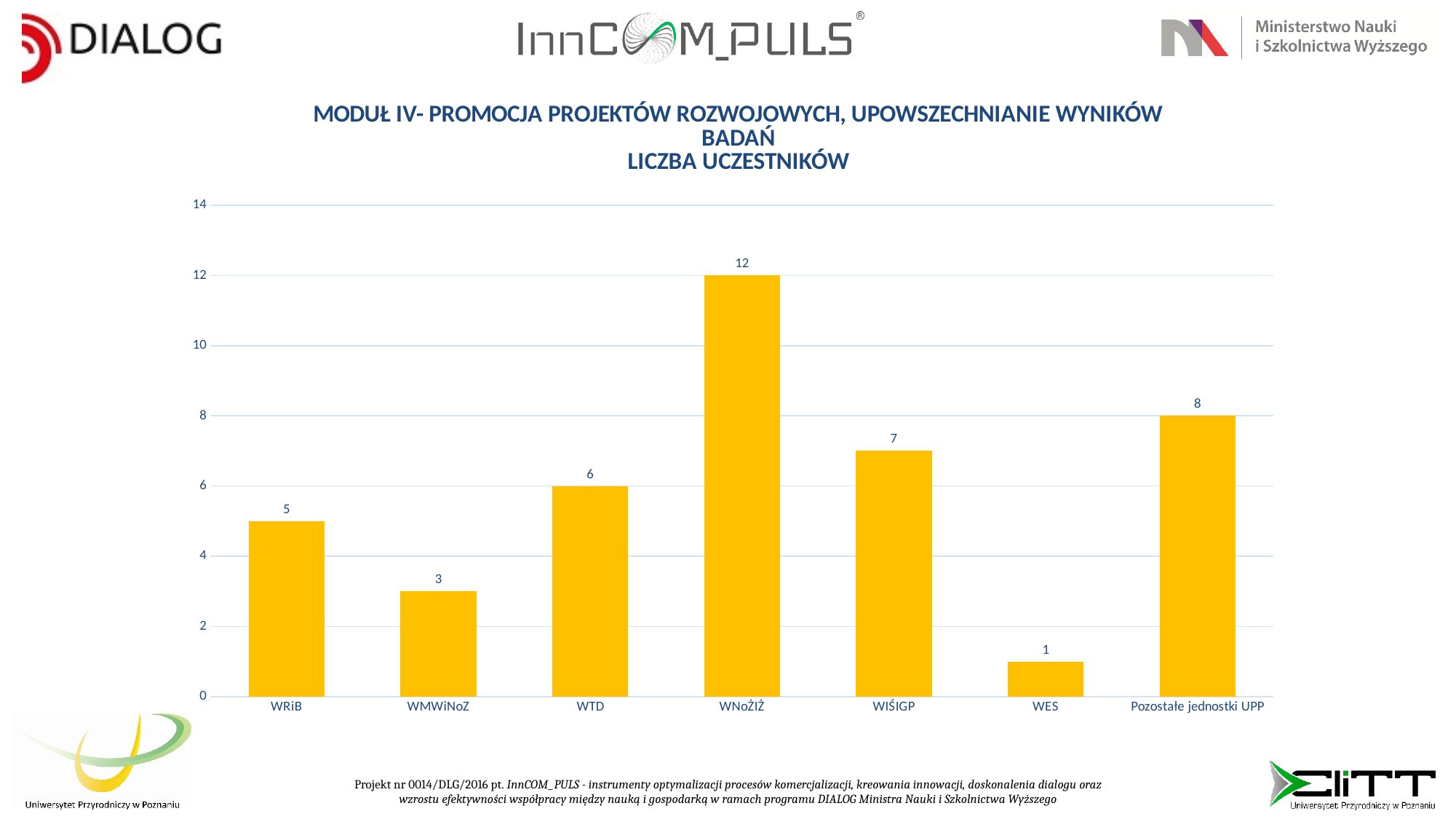
Which is larger, the value for WRiB or the value for WTD? WTD What is the value for WES? 1 What kind of chart is shown on the slide? bar chart What is the difference between the values for WNoŻIŻ and WIŚIGP? 5 Is the value for Pozostałe jednostki UPP greater or less than 6? greater What is the maximum value shown on the y axis? 14 What is the value for WMWiNoZ? 3 Which category has the lowest value? WES What is the value for Pozostałe jednostki UPP? 8 How many categories are shown on the x axis? 7 What is the value for WNoŻIŻ? 12 Which category has the highest value? WNoŻIŻ